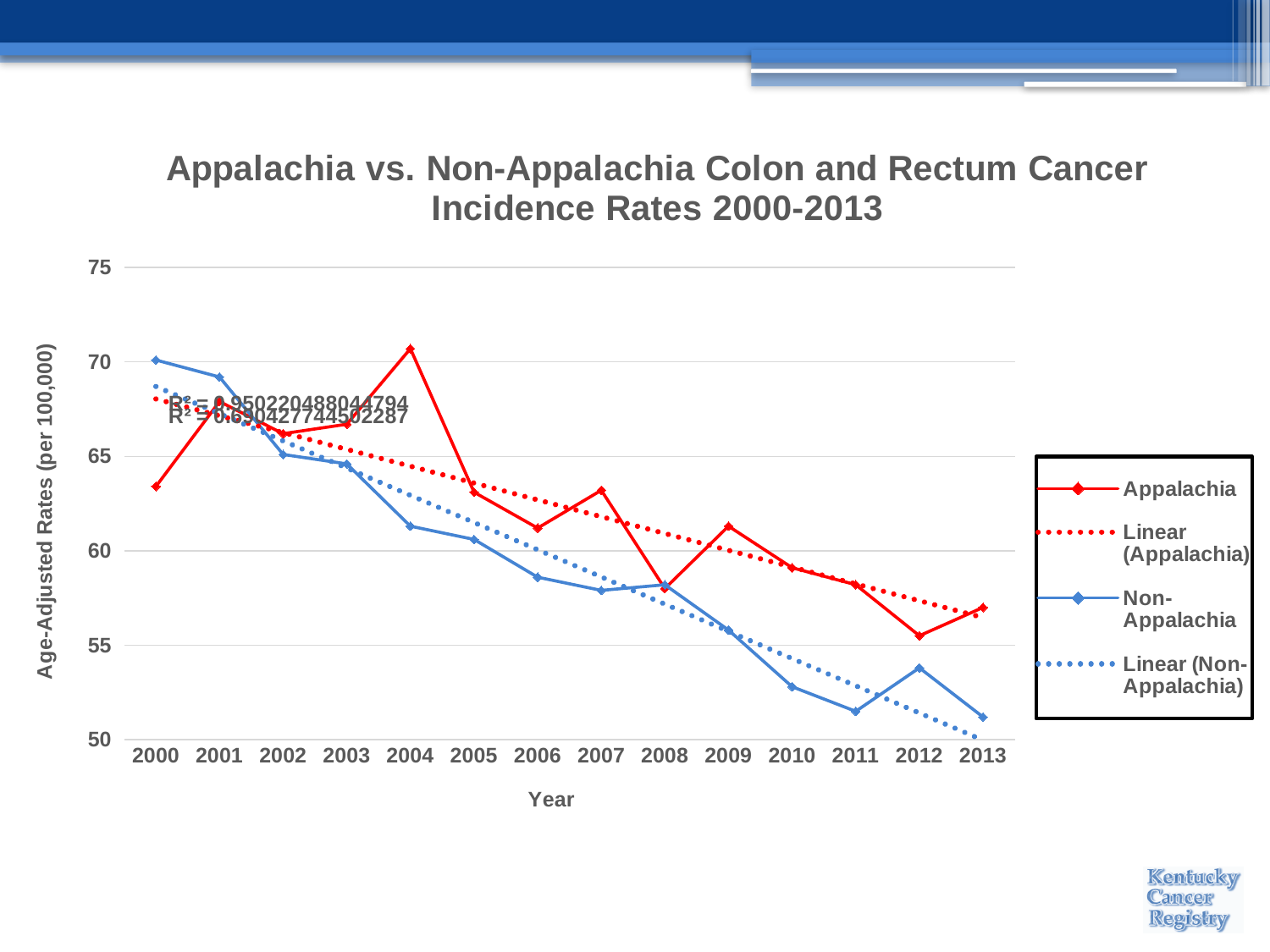
What is the title of the chart? Appalachia vs. Non-Appalachia Colon and Rectum Cancer Incidence Rates 2000-2013 Do the Non-Appalachia values generally rise or fall from 2000 to 2013? Fall In which year does the Appalachia series reach its lowest value? 2012 What is the label of the y axis? Age-Adjusted Rates (per 100,000) In which year does the Appalachia series reach its highest value? 2004 How many years are plotted along the x axis? 14 Is the Appalachia value for 2004 greater or less than 70? greater What kind of chart is shown on the slide? Line chart Is the Non-Appalachia value for 2010 greater or less than 55? less In 2000, which series has the higher value, Appalachia or Non-Appalachia? Non-Appalachia In which year does the Non-Appalachia series reach its highest value? 2000 How many entries does the legend list? 4